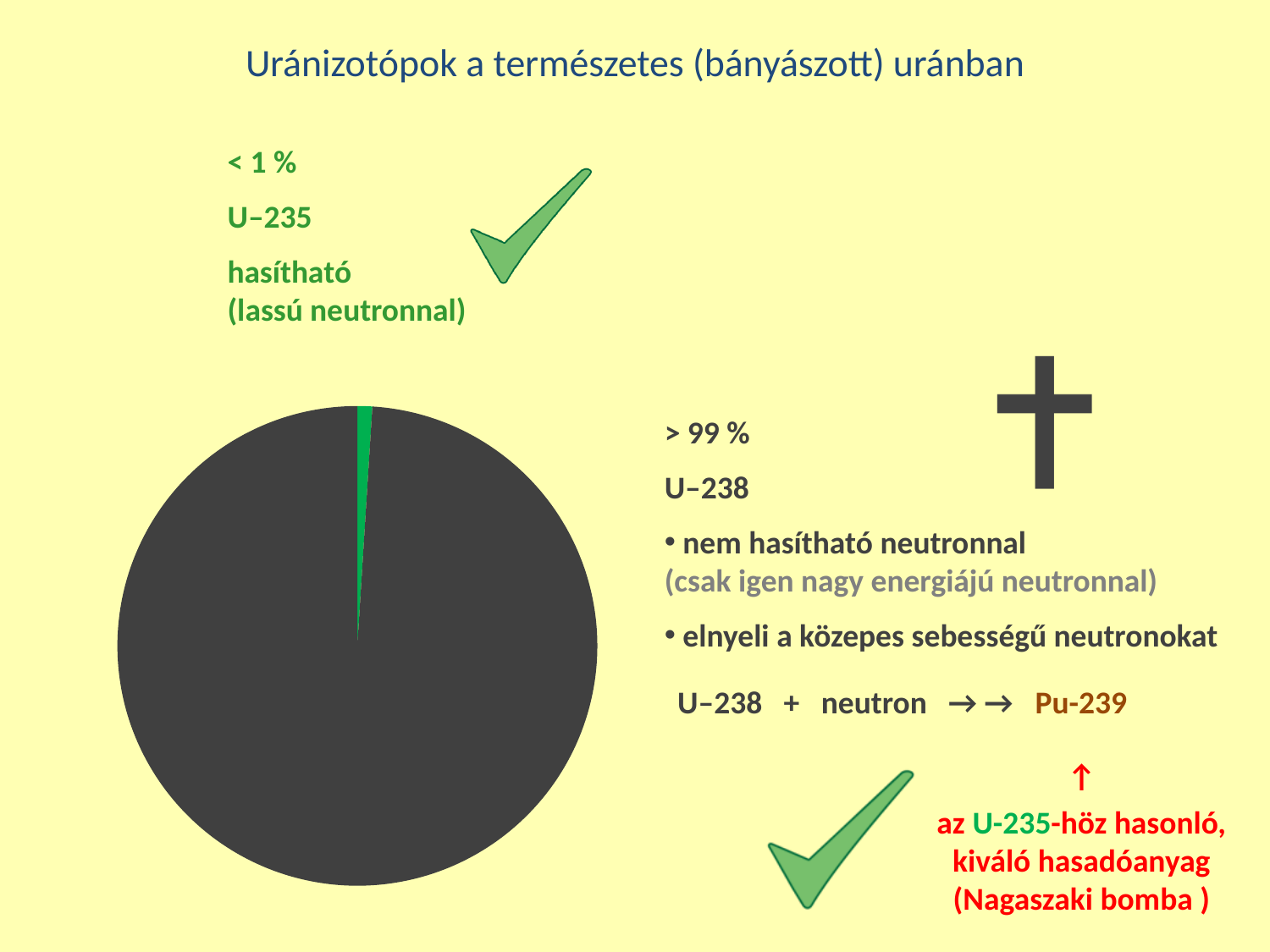
What is the title of the slide containing the pie chart? Uránizotópok a természetes (bányászott) uránban How many slices does the pie chart have? 2 Which isotope does the largest slice of the pie chart represent? U–238 Which isotope does the smallest slice of the pie chart represent? U–235 What share of natural uranium is stated for U–235 on the slide? < 1 % What share of natural uranium is stated for U–238 on the slide? > 99 % Which slice is larger in the pie chart, U–235 or U–238? U–238 What colour is the U–235 slice in the pie chart? green What kind of chart is shown on the slide? pie chart